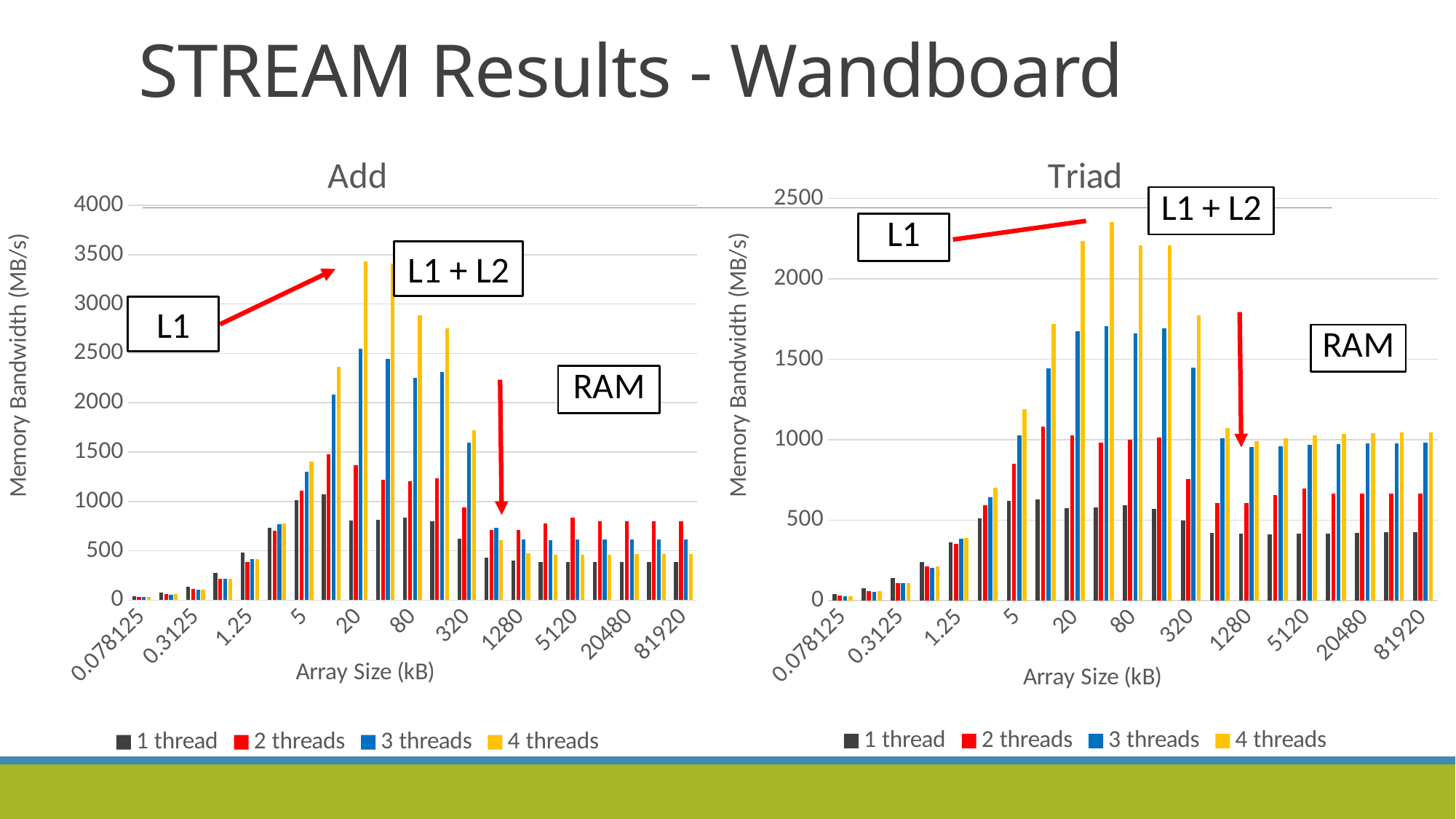
In the Triad chart, at array size 81920, which is larger: 1 thread or 3 threads? 3 threads In the Add chart, which series reaches the highest bandwidth overall? 4 threads How many series does the legend of the Triad chart list? 4 What is the x-axis label on the Add chart? Array Size (kB) In the Triad chart, is the value for 4 threads at array size 20 greater or less than 2000? greater In the Add chart, is the value for 1 thread at array size 81920 greater or less than 500? less What kind of chart is the Add chart? bar chart In the Add chart, at array size 81920, which is larger: 1 thread or 2 threads? 2 threads What are the titles of the two charts on the slide? Add and Triad In the Triad chart, does the 1 thread bandwidth rise or fall from array size 0.078125 to 5? rise In the Add chart, is the value for 4 threads at array size 20 greater or less than 3000? greater